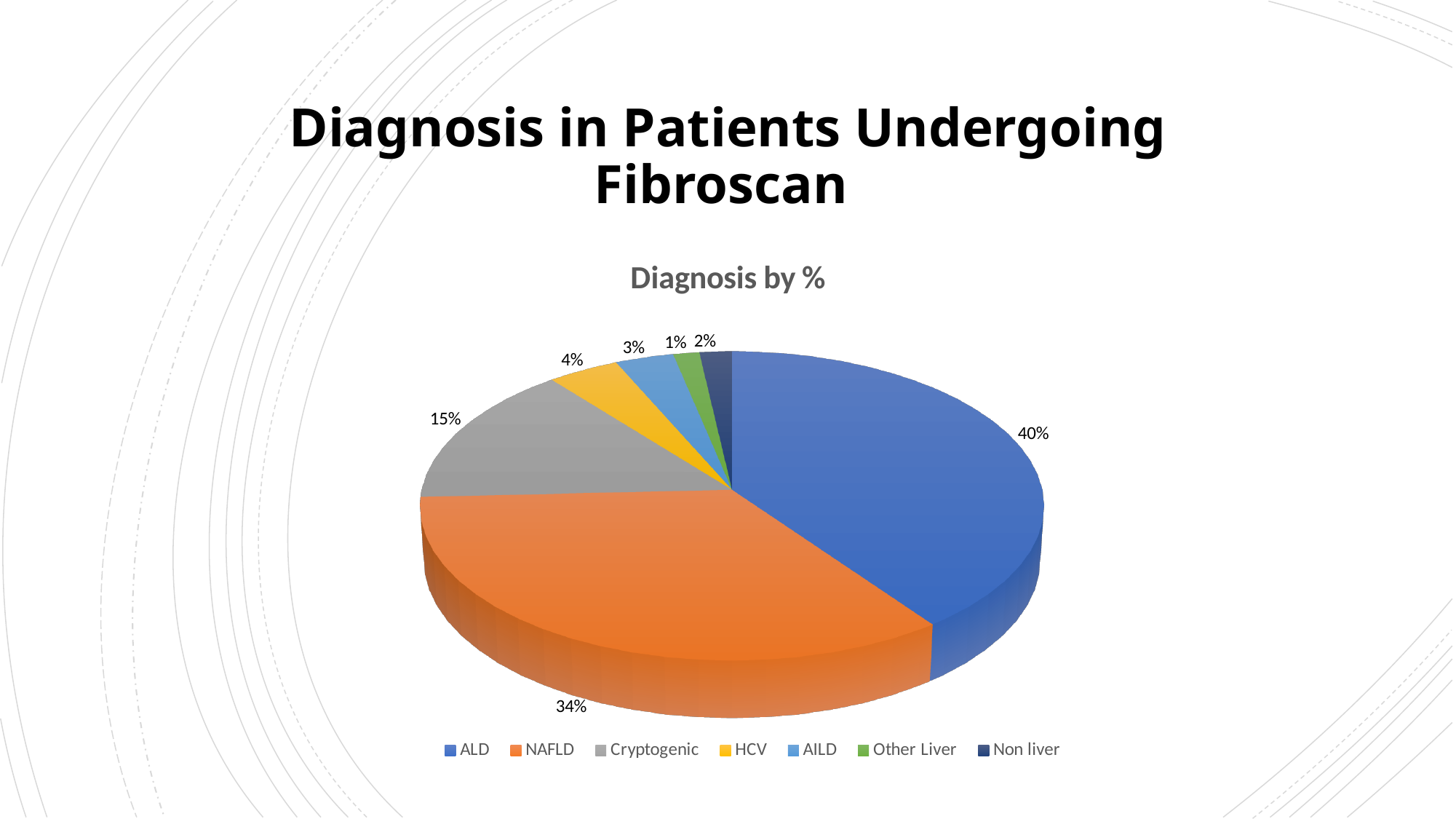
Which is larger, the share for Cryptogenic or the share for HCV? Cryptogenic What percentage of patients have a diagnosis of NAFLD? 34% Which diagnosis has the largest share of the pie? ALD Which diagnosis has the smallest share of the pie? Other Liver What is the chart's title? Diagnosis by % How many diagnosis categories does the legend list? 7 What percentage is shown for Cryptogenic? 15% What percentage is shown for AILD? 3% What percentage of patients have a diagnosis of ALD? 40% What is the difference in percentage points between ALD and NAFLD? 6 What percentage is shown for HCV? 4% What kind of chart is shown on the slide? pie chart